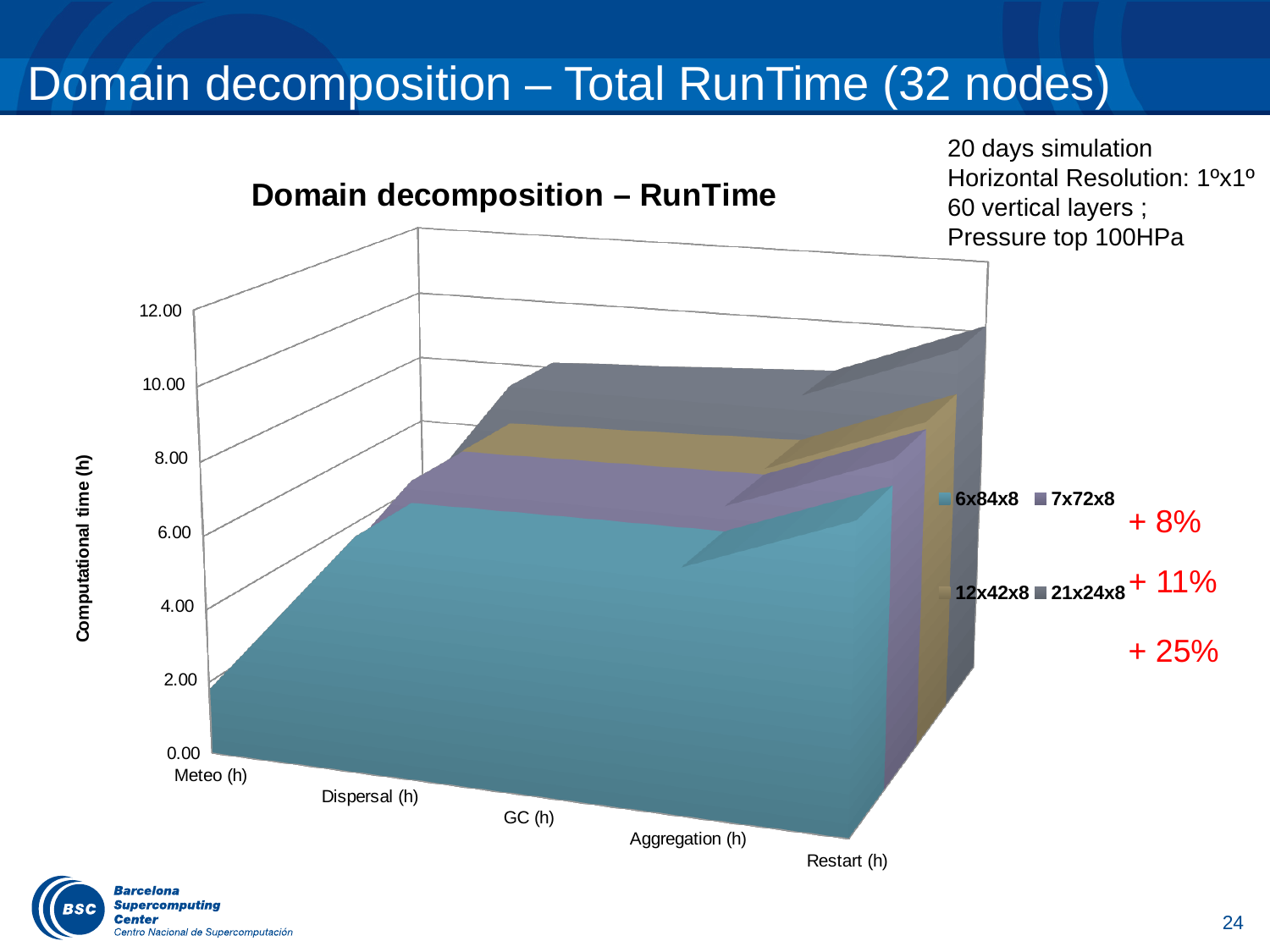
How many series does the chart's legend list? 4 Which category is last along the x axis of the chart? Restart (h) Which category has the lowest computational time for the 6x84x8 series? Meteo (h) What is the title of the chart? Domain decomposition – RunTime What is the label of the vertical axis of the chart? Computational time (h) Is the value for Meteo (h) in the 6x84x8 series greater or less than 6.00? less Which category is first along the x axis of the chart? Meteo (h) What kind of chart is shown on the slide? area chart What is the highest tick value shown on the vertical axis of the chart? 12.00 Does the computational time for the 6x84x8 series rise or fall from Meteo (h) to Dispersal (h)? rise How many categories are shown along the x axis of the chart? 5